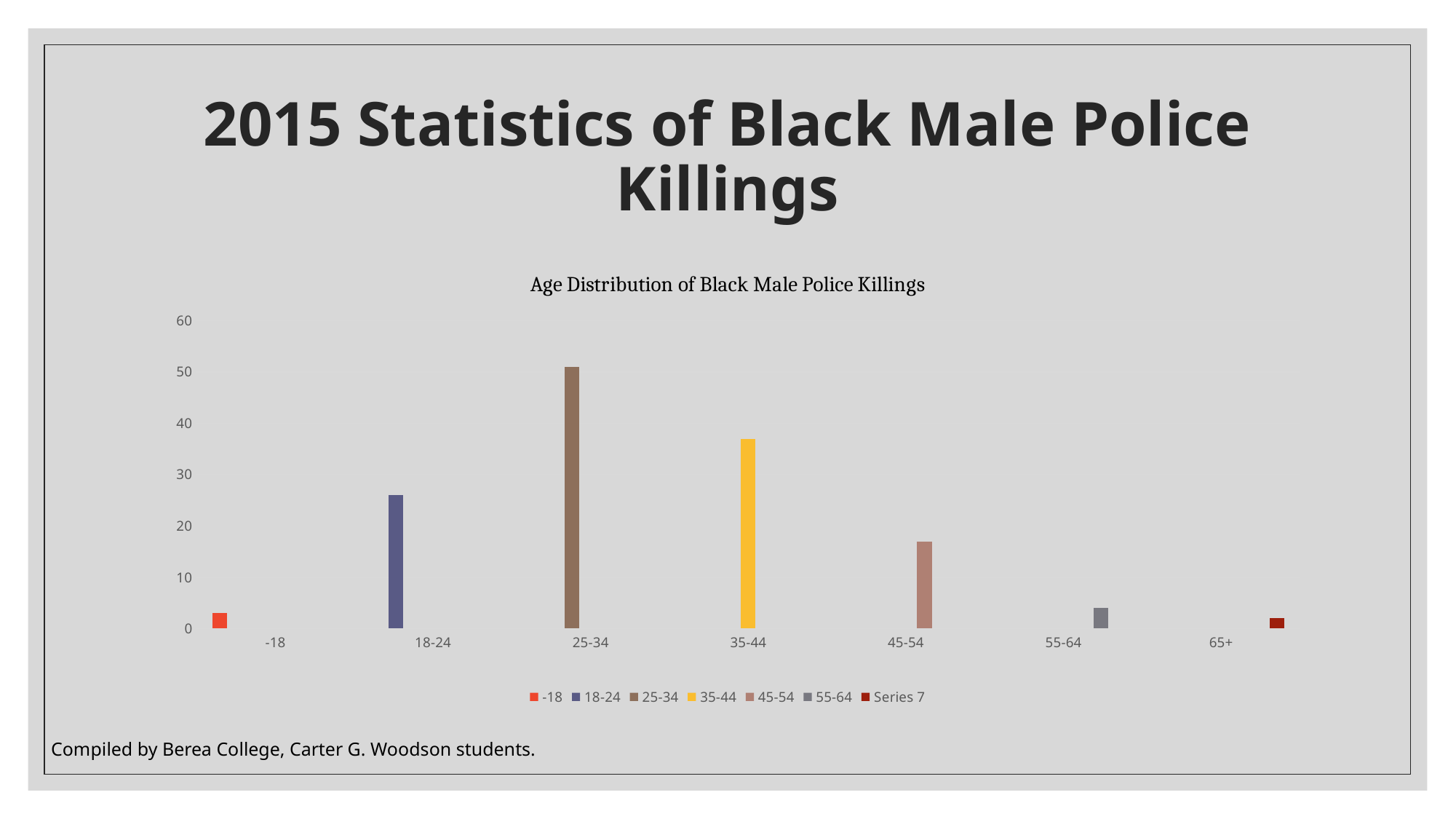
What kind of chart is shown on the slide? bar chart Is the value for 25-34 greater or less than 40? greater How many age categories are shown on the x axis? 7 Which is larger, the value for 45-54 or the value for 55-64? 45-54 How many series does the legend list? 7 What is the title of the chart? Age Distribution of Black Male Police Killings Is the value for -18 greater or less than 10? less Which is larger, the value for 18-24 or the value for 35-44? 35-44 Is the value for 35-44 greater or less than 40? less Which age category has the highest value? 25-34